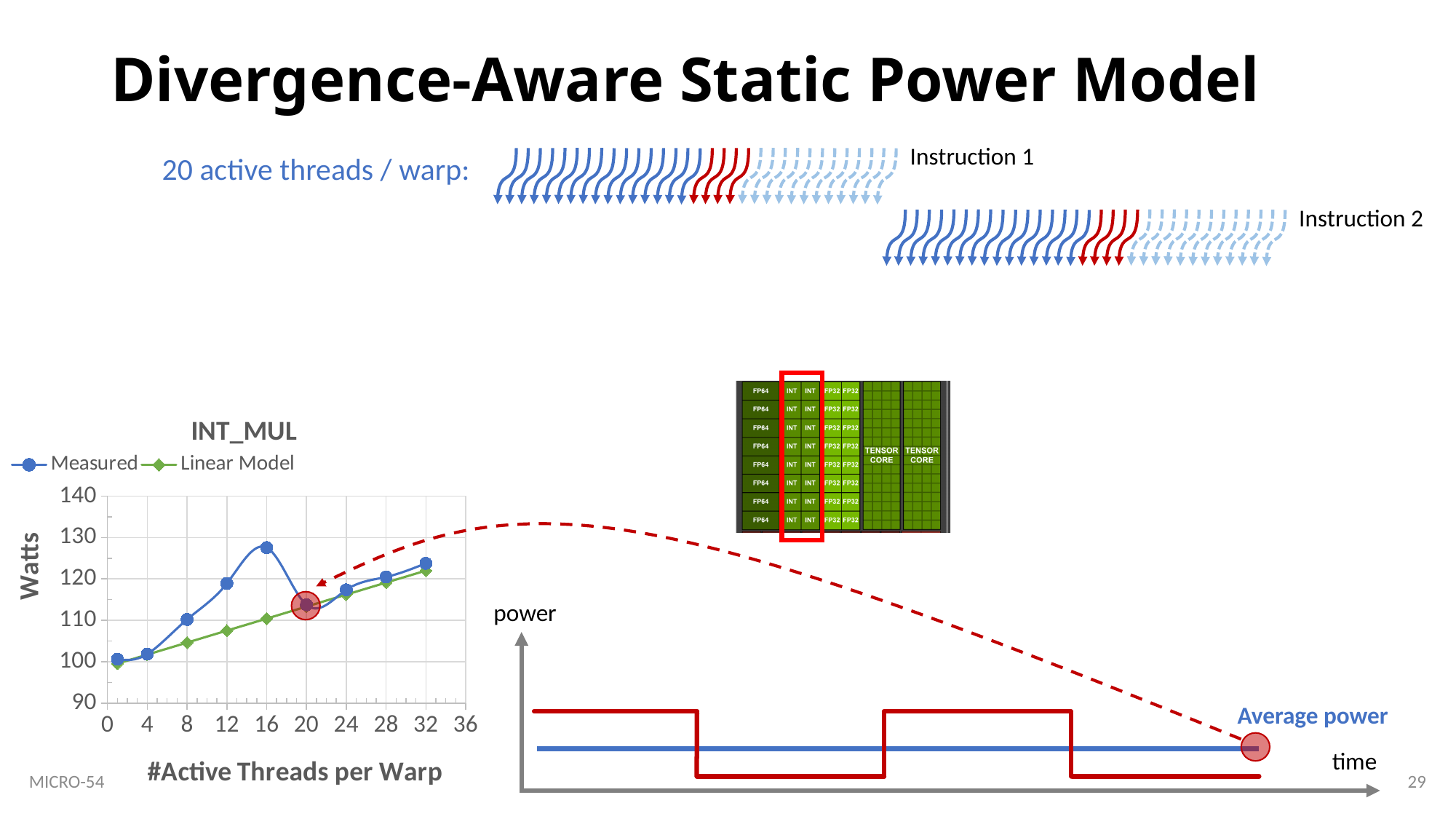
What is the title of the chart on the left of the slide? INT_MUL In the INT_MUL chart, at which number of active threads per warp does the Measured series reach its highest value? 16 In the INT_MUL chart, at 12 active threads per warp, which series has the larger value, Measured or Linear Model? Measured In the INT_MUL chart, is the Measured value at 4 active threads per warp greater or less than 110? less In the INT_MUL chart, is the Measured value at 16 active threads per warp greater or less than 130? less In the INT_MUL chart, does the Linear Model series rise or fall as the number of active threads per warp increases? rise What kind of chart is the INT_MUL chart? line chart How many series does the legend of the INT_MUL chart list? 2 In the INT_MUL chart, is the Measured value at 16 active threads per warp greater or less than 120? greater What is the label of the y axis of the INT_MUL chart? Watts How many data points does the Linear Model series have in the INT_MUL chart? 9